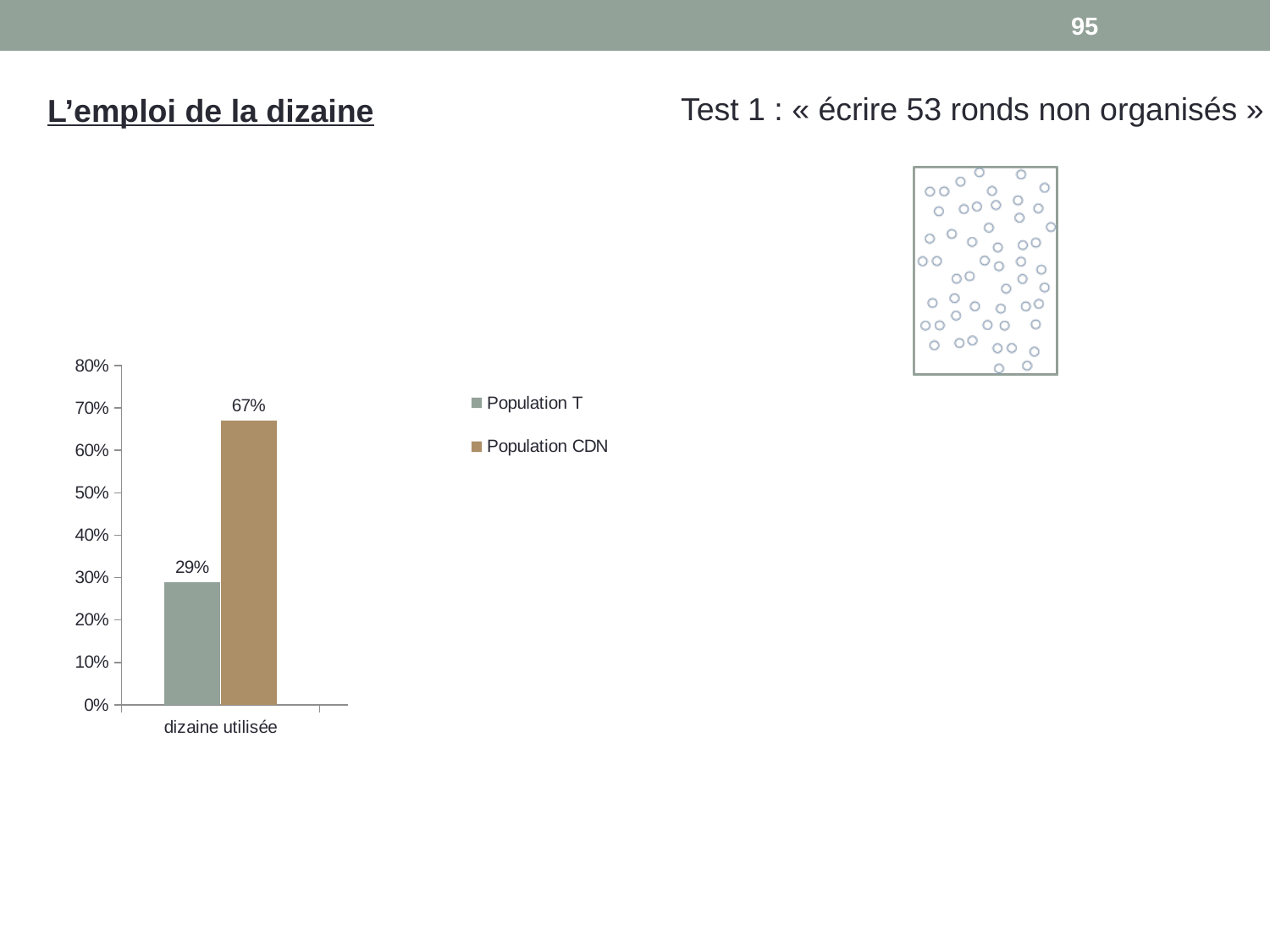
What kind of chart is shown on the slide? bar chart What is the highest value shown on the y axis of the chart? 80% Is the value for Population CDN greater or less than 60%? greater What is the category label on the x axis of the chart? dizaine utilisée How many categories are shown on the x axis? 1 How many series does the legend list? 2 Is the value for Population T greater or less than 30%? less Which series has the higher value for "dizaine utilisée"? Population CDN What is the value for Population CDN for "dizaine utilisée"? 67% What is the value for Population T for "dizaine utilisée"? 29% Which series has the lower value for "dizaine utilisée"? Population T What is the difference between the Population CDN and Population T values for "dizaine utilisée"? 38%